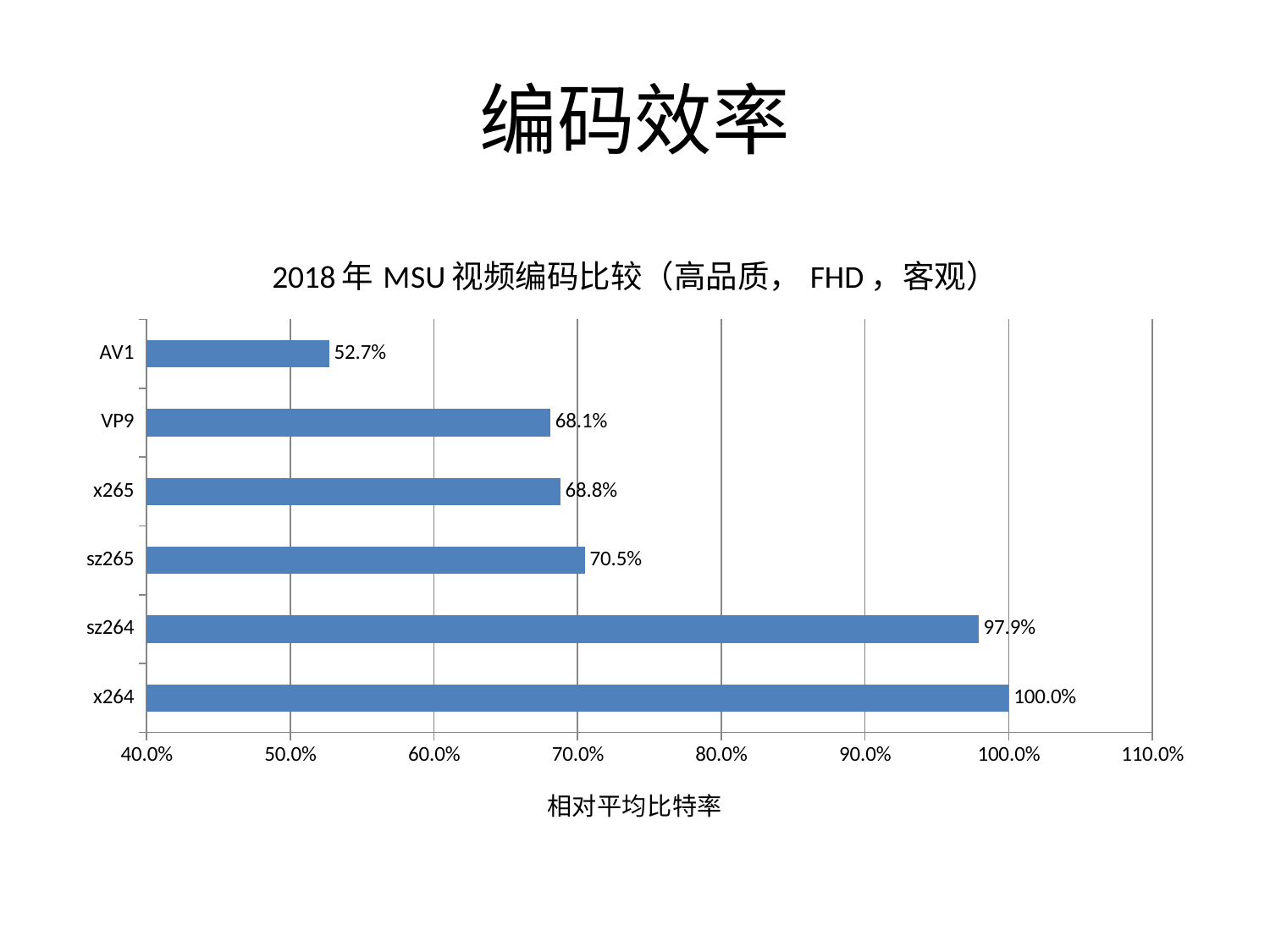
What is the relative average bitrate value for AV1? 52.7% Which codec has the highest relative average bitrate? x264 What is the title of the chart? 2018 年 MSU 视频编码比较（高品质， FHD ，客观） Which codec has the lowest relative average bitrate? AV1 What is the difference between the values for sz265 and VP9? 2.4% What kind of chart is shown on the slide? bar chart How many codecs are shown in the chart? 6 Which has a larger value, sz264 or sz265? sz264 Is the value for VP9 greater or less than 70.0%? less What is the value shown for sz264? 97.9% What is the value shown for x265? 68.8% What is the difference between the values for x264 and AV1? 47.3%